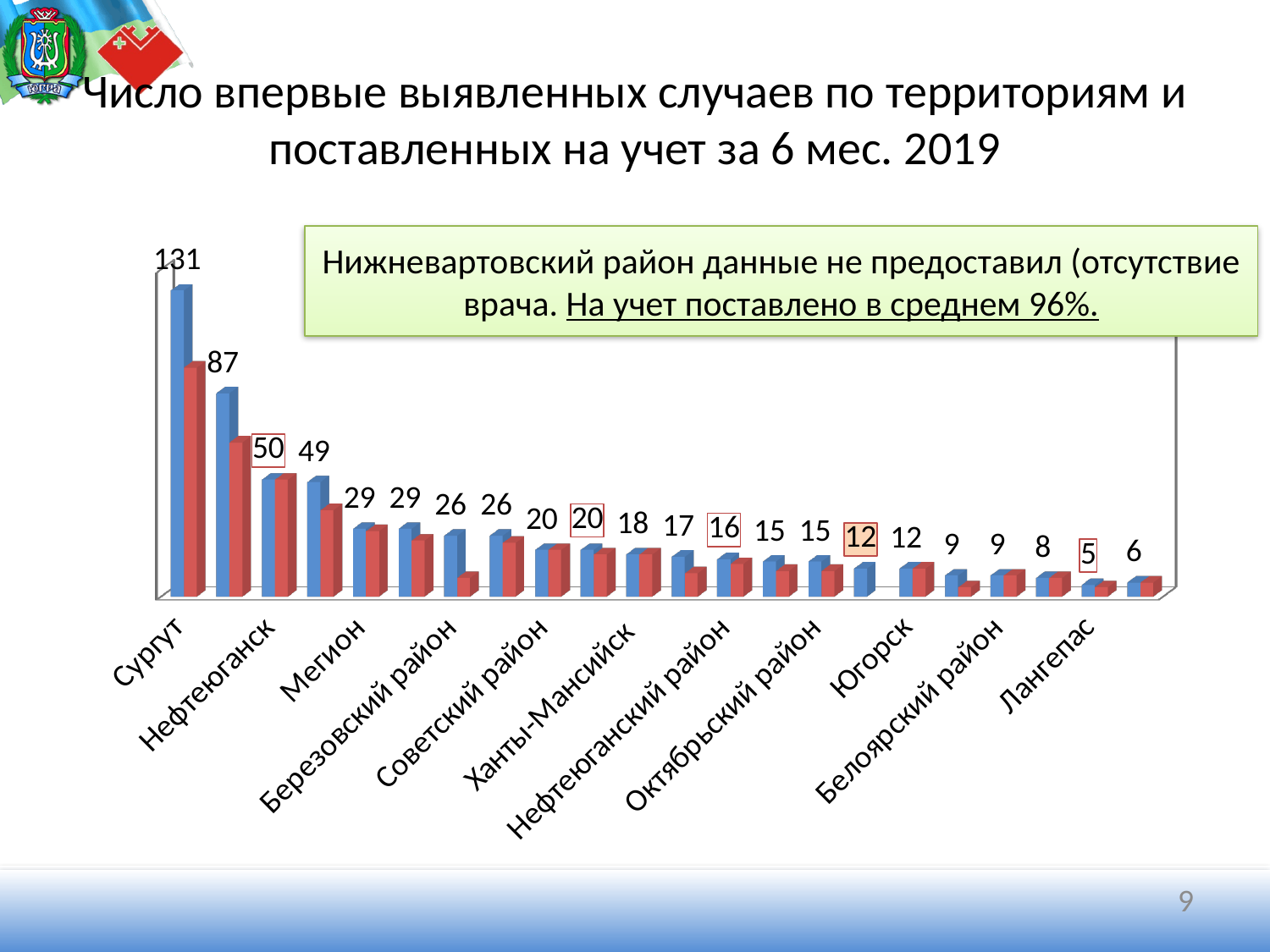
According to the text box on the chart, what average percentage was registered (поставлено на учет)? 96% What is the difference between the blue bar values for Сургут and Нефтеюганск? 81 What kind of chart is shown on the slide? bar chart Do the values generally rise or fall from left to right along the x axis? fall What is the highest value labelled on the chart? 131 What is the value of the blue bar for Нефтеюганск? 50 What is the value of the blue bar for Сургут? 131 What is the value of the blue bar for Лангепас? 5 Which has a larger blue bar value, Сургут or Мегион? Сургут What is the value of the blue bar for Югорск? 12 Which territory has the highest number of newly identified cases? Сургут How many differently coloured bar series are plotted for each territory? 2